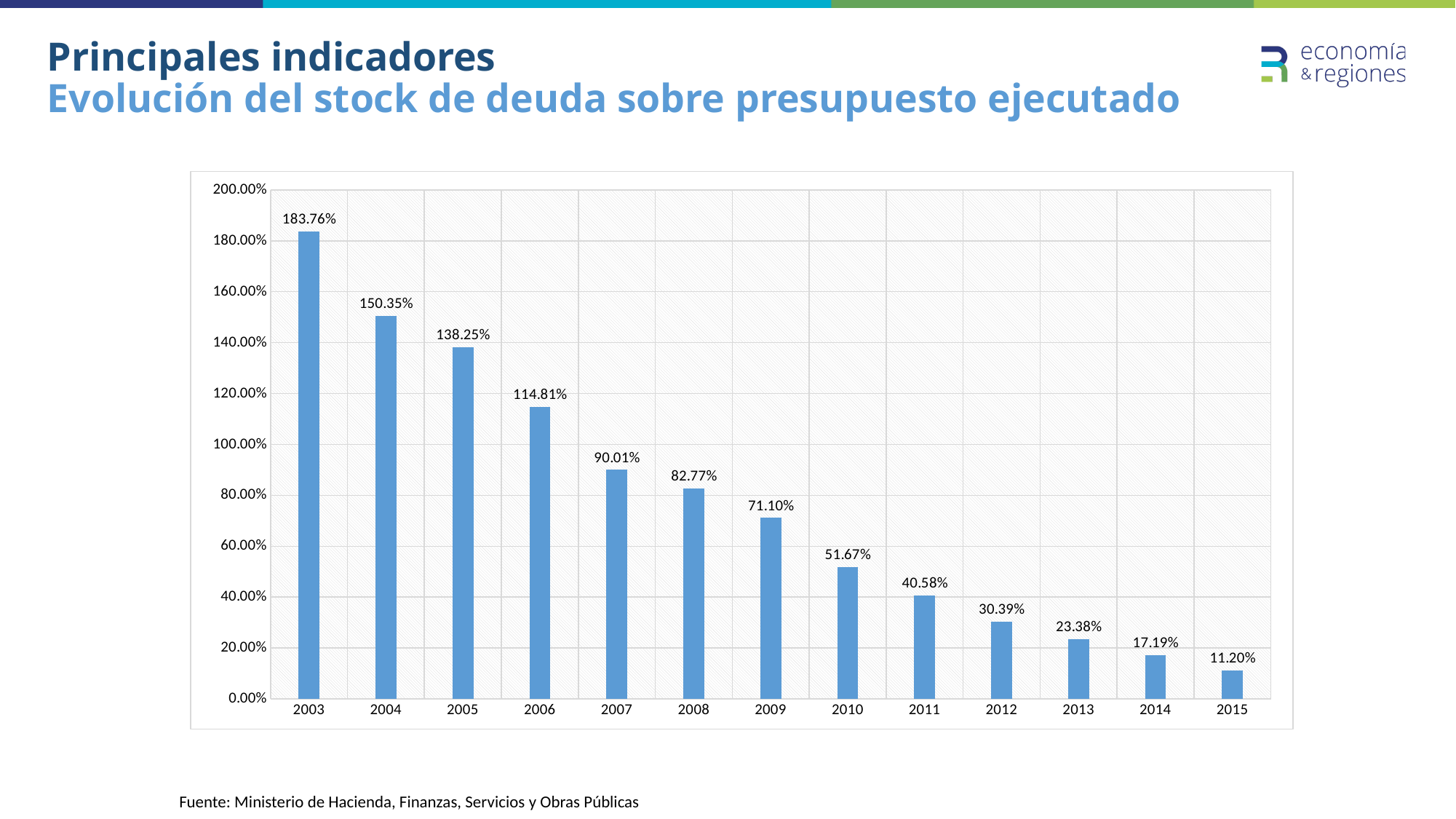
What is the difference between the values for 2007 and 2008? 7.24% What is the value for 2003? 183.76% What is the value for 2009? 71.10% What is the value for 2015? 11.20% What kind of chart is shown on the slide? bar chart Which year has the highest value? 2003 What is the difference between the values for 2003 and 2004? 33.41% Which is larger, the value for 2006 or the value for 2010? 2006 Which year has the lowest value? 2015 Is the value for 2011 greater or less than 60.00%? less How many years are shown on the x axis? 13 Do the values rise or fall from 2003 to 2015? fall